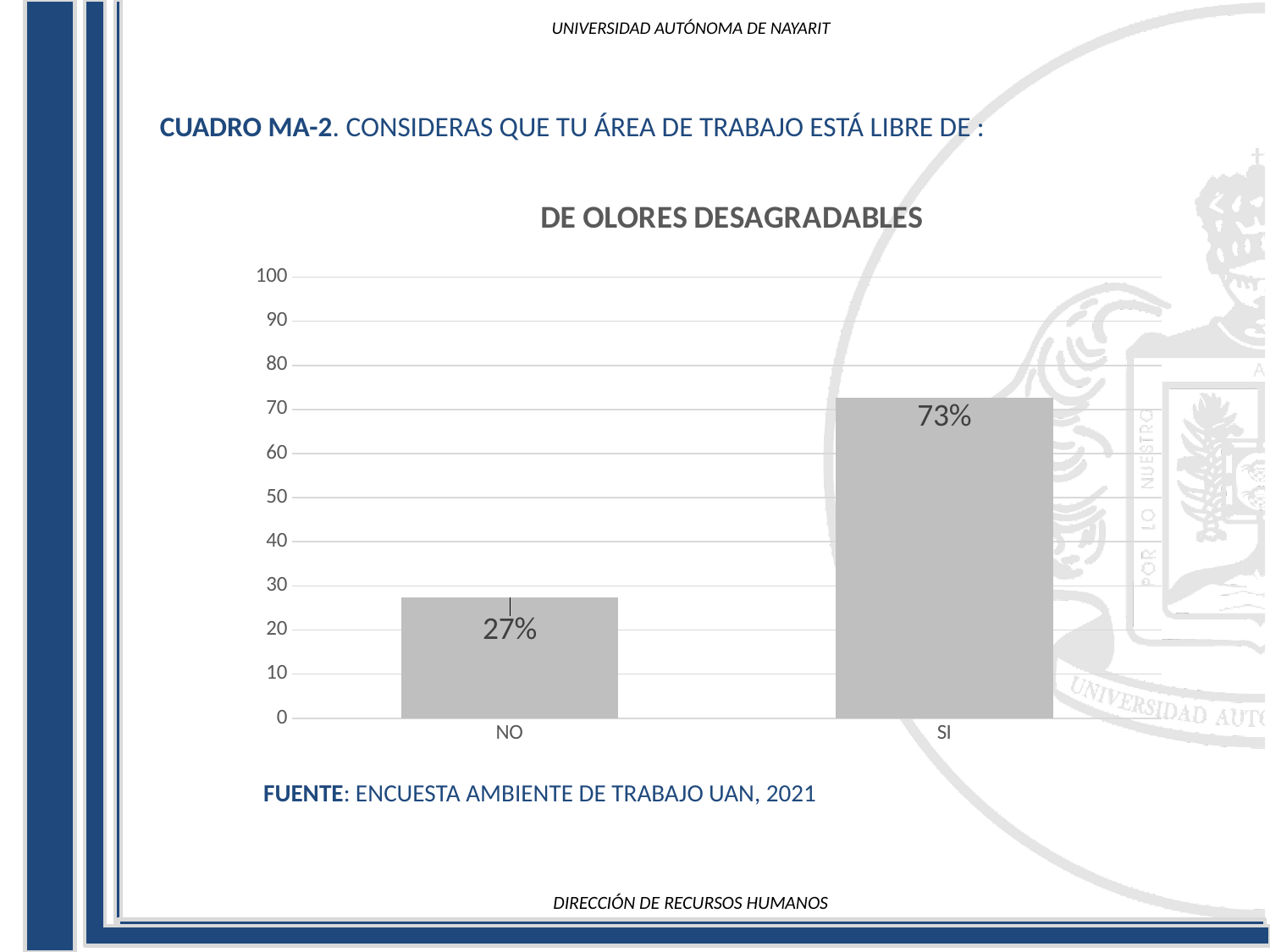
Is the value for SI greater or less than 70? greater What is the title of the chart? DE OLORES DESAGRADABLES Which category has the lowest value? NO What is the difference between the values for SI and NO? 46% Which category has the highest value? SI How many categories are shown on the x axis? 2 Is the value for NO greater or less than 30? less What is the value for NO? 27% Which is larger, the value for NO or the value for SI? SI What is the highest value shown on the y axis? 100 What kind of chart is shown on the slide? bar chart What is the value for SI? 73%